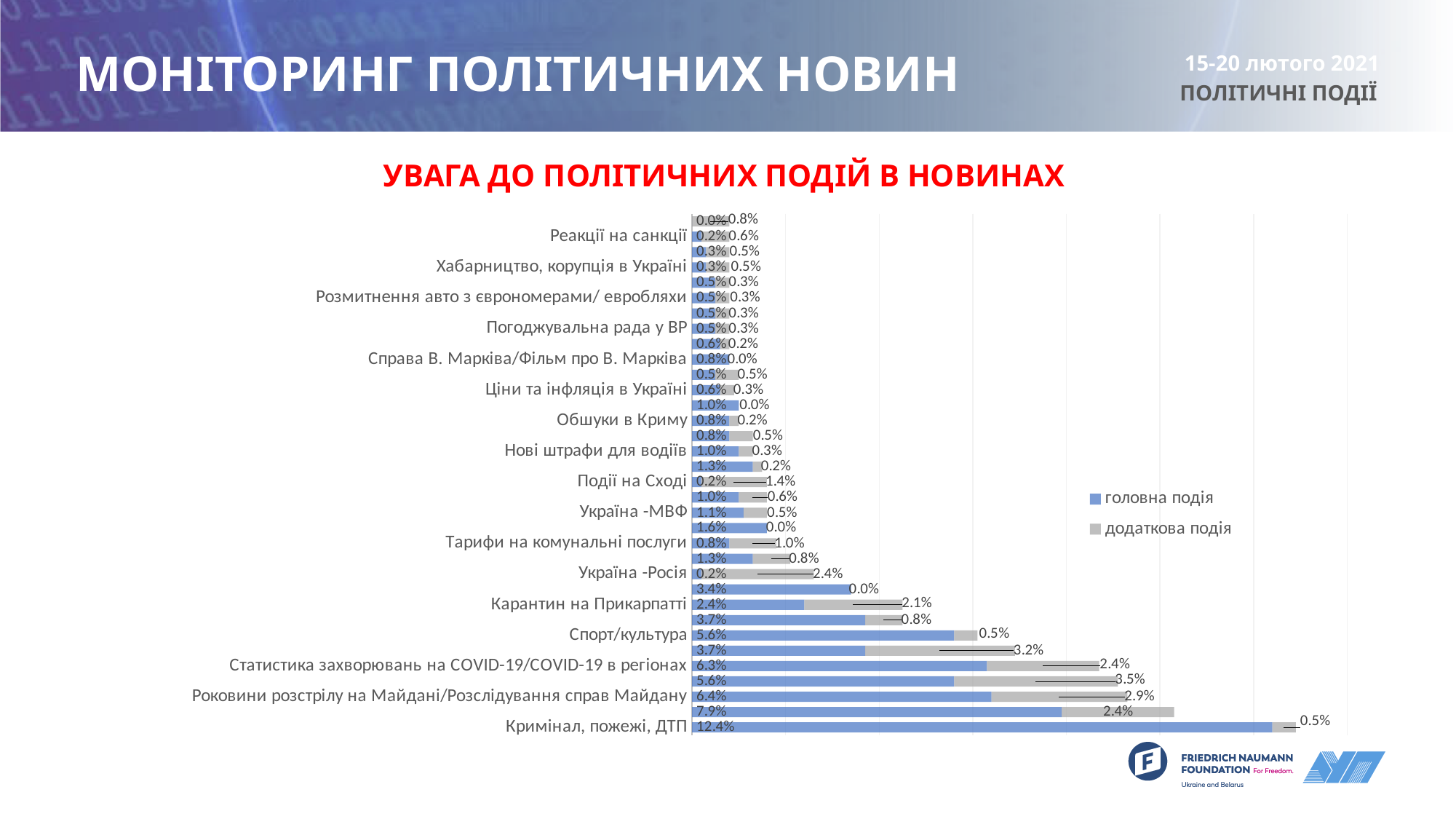
What is the value of додаткова подія for Україна -Росія? 2.4% What kind of chart is shown on the slide? Bar chart What are the two series named in the legend? головна подія and додаткова подія What is the value of головна подія for Карантин на Прикарпатті? 2.4% What is the total of the stacked bar for Статистика захворювань на COVID-19/COVID-19 в регіонах? 8.7% Which category has the highest value for головна подія? Кримінал, пожежі, ДТП What is the value of додаткова подія for Роковини розстрілу на Майдані/Розслідування справ Майдану? 2.9% Which is larger for Тарифи на комунальні послуги: головна подія or додаткова подія? додаткова подія What is the difference between the головна подія values for Кримінал, пожежі, ДТП and Спорт/культура? 6.8% How many series does the chart legend list? 2 What is the value of головна подія for Кримінал, пожежі, ДТП? 12.4% What is the value of головна подія for Спорт/культура? 5.6%